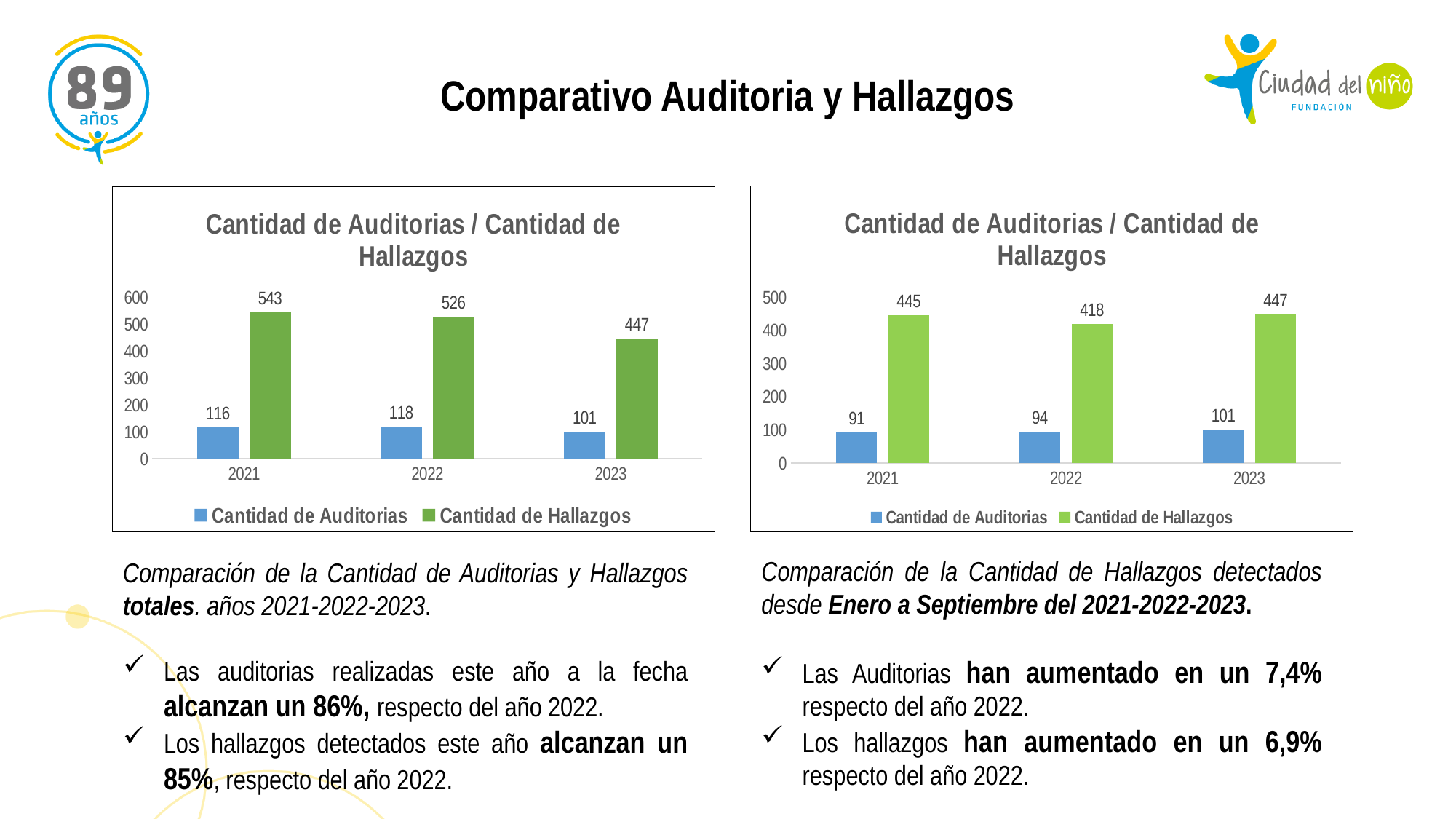
In the left chart, what is the Cantidad de Hallazgos for 2021? 543 What type of chart is the left chart? bar chart In the left chart, what is the difference between the Cantidad de Hallazgos in 2022 and 2023? 79 How many series does the legend of the right chart list? 2 In the left chart, which year has the highest Cantidad de Hallazgos? 2021 In the right chart, what is the Cantidad de Hallazgos for 2022? 418 In the right chart, what is the Cantidad de Auditorias for 2021? 91 In the right chart, what is the difference between the Cantidad de Hallazgos in 2023 and 2022? 29 In the left chart, what is the Cantidad de Auditorias for 2023? 101 In the left chart, does the Cantidad de Hallazgos fall or rise from 2021 to 2023? fall In the right chart, which year has the lowest Cantidad de Auditorias? 2021 In the right chart, which is larger: the Cantidad de Auditorias in 2022 or in 2023? 2023